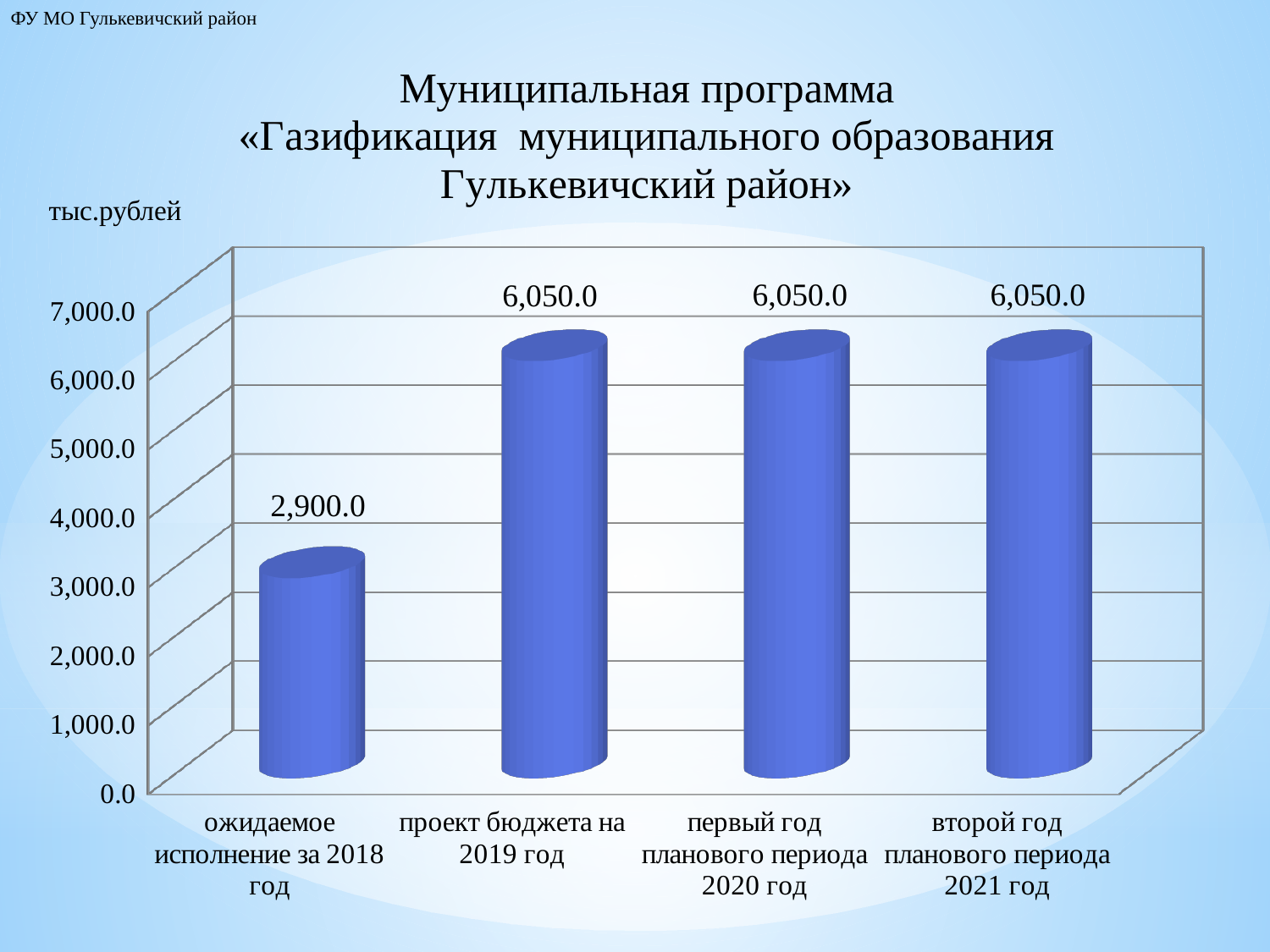
What is the value for «проект бюджета на 2019 год»? 6,050.0 Which category has the lowest value? ожидаемое исполнение за 2018 год What is the value for «ожидаемое исполнение за 2018 год»? 2,900.0 In what units are the values on the chart expressed? тыс.рублей How many categories are shown on the x axis? 4 Is the value for «ожидаемое исполнение за 2018 год» greater or less than 3,000.0? less What kind of chart is shown on the slide? bar chart What is the difference between the value for 2019 (проект бюджета) and the value for 2018 (ожидаемое исполнение)? 3,150.0 What is the value for «второй год планового периода 2021 год»? 6,050.0 What is the value for «первый год планового периода 2020 год»? 6,050.0 Which is larger: the value for «проект бюджета на 2019 год» or the value for «ожидаемое исполнение за 2018 год»? проект бюджета на 2019 год Do the values rise or fall from 2018 to 2019? rise